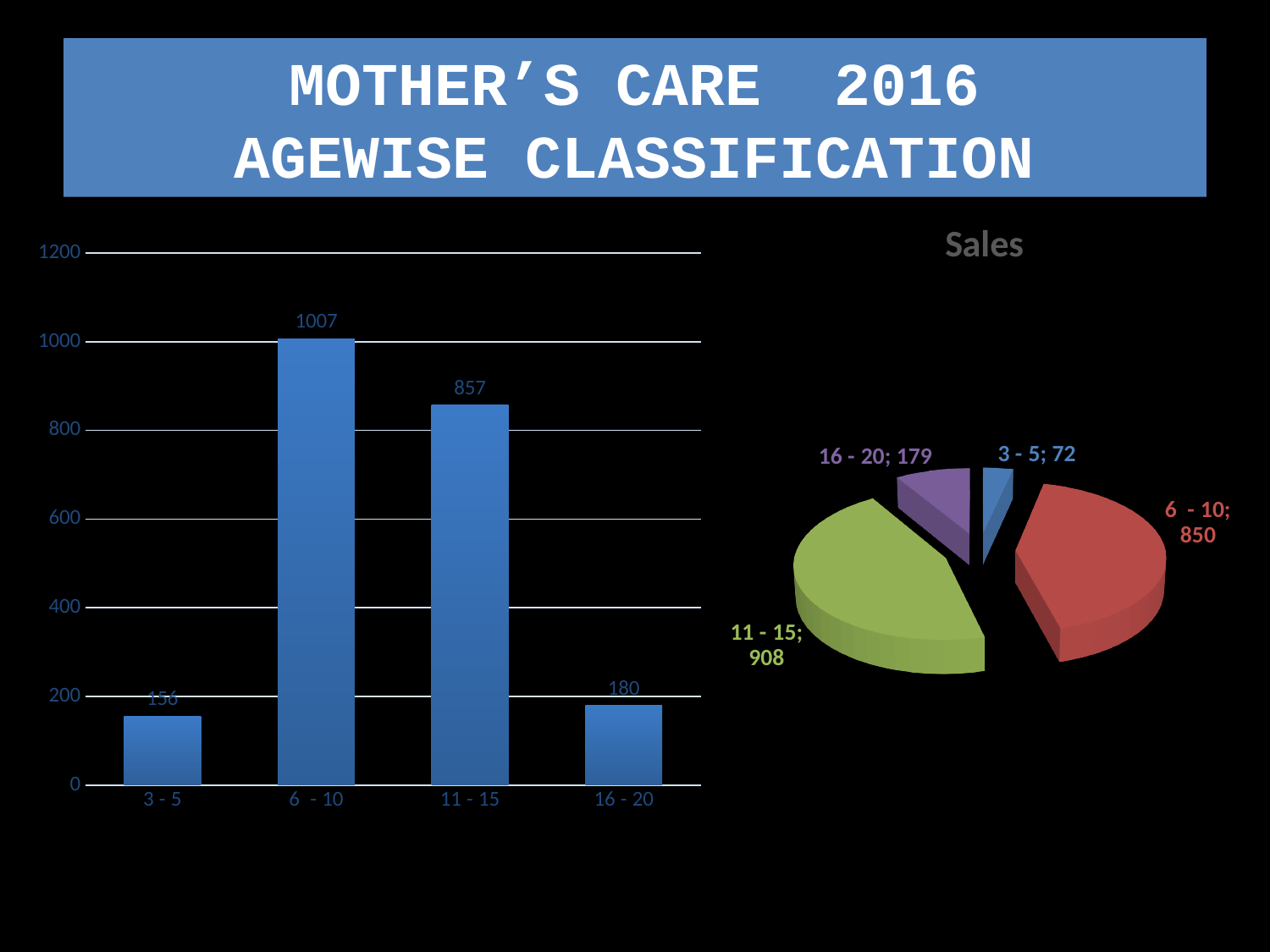
In the Sales pie chart, which is larger, the 16 - 20 slice or the 3 - 5 slice? 16 - 20 In the bar chart on the left, how many categories are shown on the x axis? 4 In the bar chart on the left, which category has the lowest value? 3 - 5 In the Sales pie chart, which slice is the largest? 11 - 15 In the bar chart on the left, what is the value for the 6 - 10 category? 1007 In the Sales pie chart, what is the value for the 11 - 15 slice? 908 What is the title of the pie chart on the right? Sales What kind of chart is the chart on the left of the slide? Bar chart In the Sales pie chart, what is the value for the 3 - 5 slice? 72 In the bar chart on the left, which category has the highest value? 6 - 10 In the bar chart on the left, what is the difference between the values for 6 - 10 and 11 - 15? 150 In the bar chart on the left, what is the value for the 16 - 20 category? 180